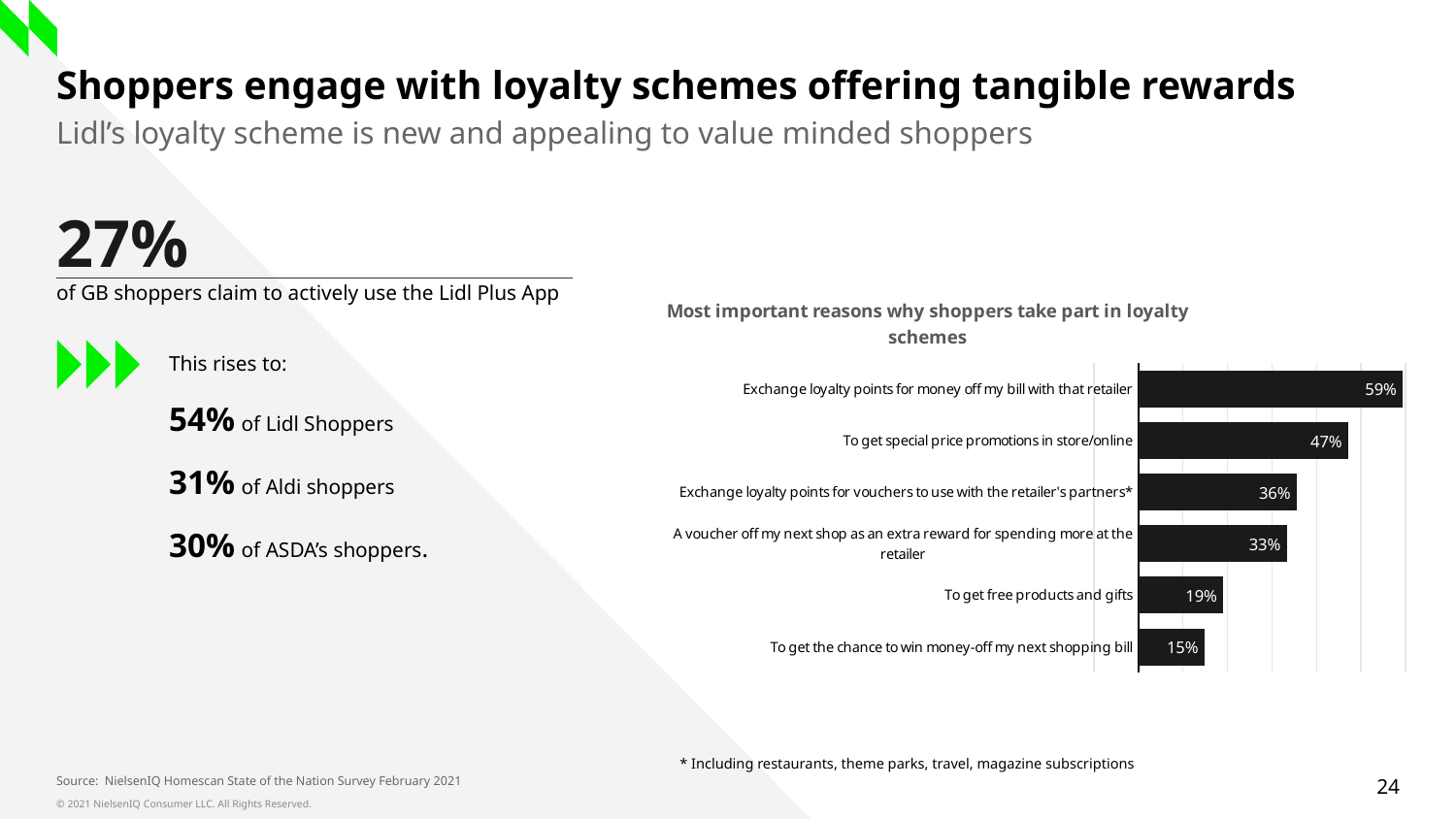
Which is larger: the value for 'Exchange loyalty points for vouchers to use with the retailer's partners*' or 'A voucher off my next shop as an extra reward for spending more at the retailer'? Exchange loyalty points for vouchers to use with the retailer's partners* Which reason has the lowest value in the chart? To get the chance to win money-off my next shopping bill What is the difference between the values for 'Exchange loyalty points for money off my bill with that retailer' and 'To get special price promotions in store/online'? 12% What kind of chart is shown on the slide? Bar chart What is the title of the chart? Most important reasons why shoppers take part in loyalty schemes What percentage of shoppers cite 'Exchange loyalty points for money off my bill with that retailer' as a most important reason for taking part in loyalty schemes? 59% What is the value for 'To get special price promotions in store/online'? 47% What colour are the bars in the chart? Black What is the difference between the values for 'To get free products and gifts' and 'To get the chance to win money-off my next shopping bill'? 4% What is the value for 'To get free products and gifts'? 19% How many reasons (categories) are shown in the chart? 6 Which reason has the highest value in the chart? Exchange loyalty points for money off my bill with that retailer